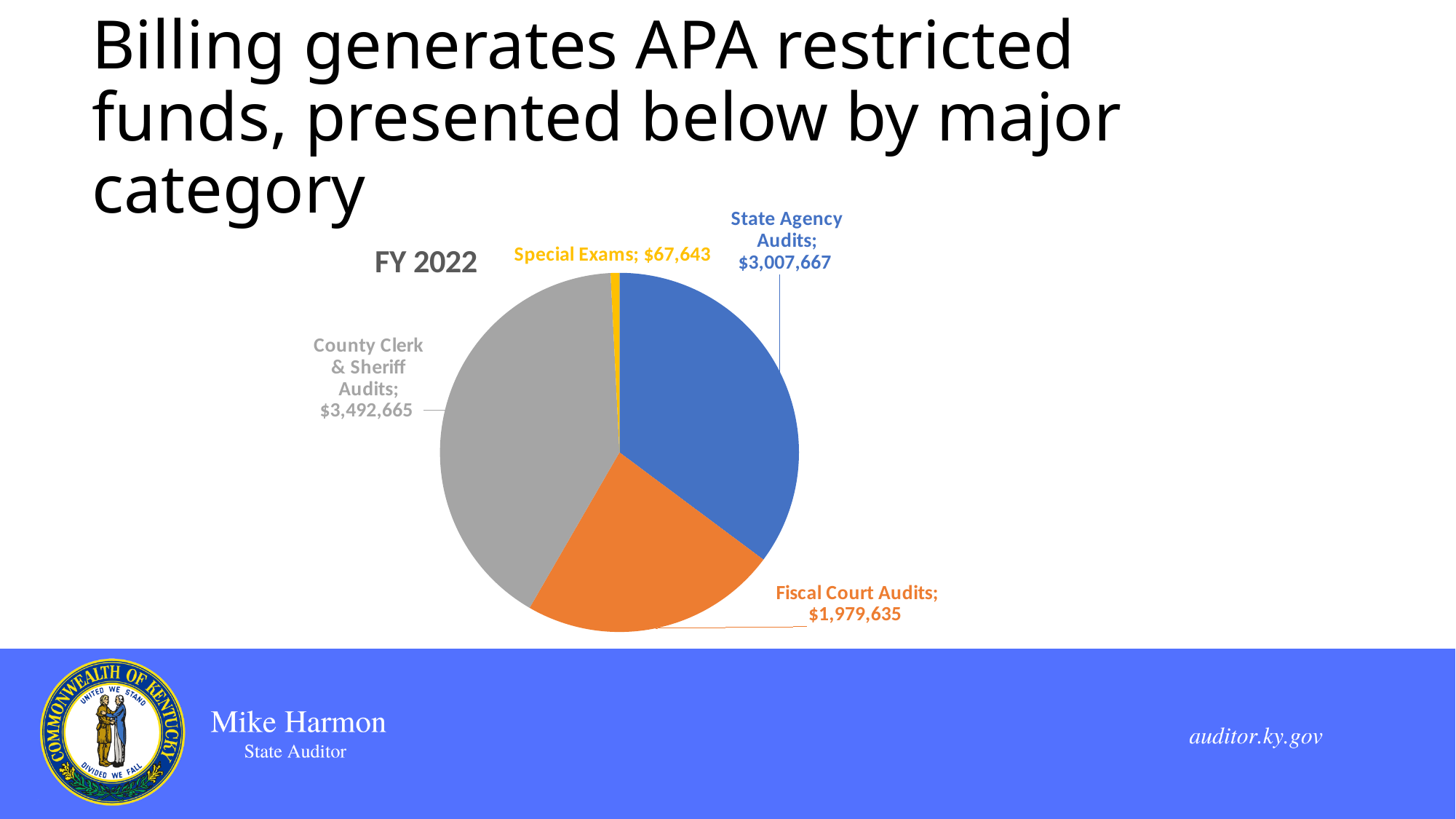
Which is larger in the FY 2022 pie chart, State Agency Audits or Fiscal Court Audits? State Agency Audits How many categories are shown in the FY 2022 pie chart? 4 What is the value for County Clerk & Sheriff Audits in the FY 2022 pie chart? $3,492,665 What is the title of the chart on the slide? FY 2022 What is the value for Special Exams in the FY 2022 pie chart? $67,643 What is the value for State Agency Audits in the FY 2022 pie chart? $3,007,667 Which category has the smallest slice in the FY 2022 pie chart? Special Exams What kind of chart is shown on the slide? Pie chart What is the difference between State Agency Audits and Fiscal Court Audits in the FY 2022 pie chart? $1,028,032 Which category has the largest slice in the FY 2022 pie chart? County Clerk & Sheriff Audits What is the value for Fiscal Court Audits in the FY 2022 pie chart? $1,979,635 What is the difference between County Clerk & Sheriff Audits and State Agency Audits in the FY 2022 pie chart? $484,998